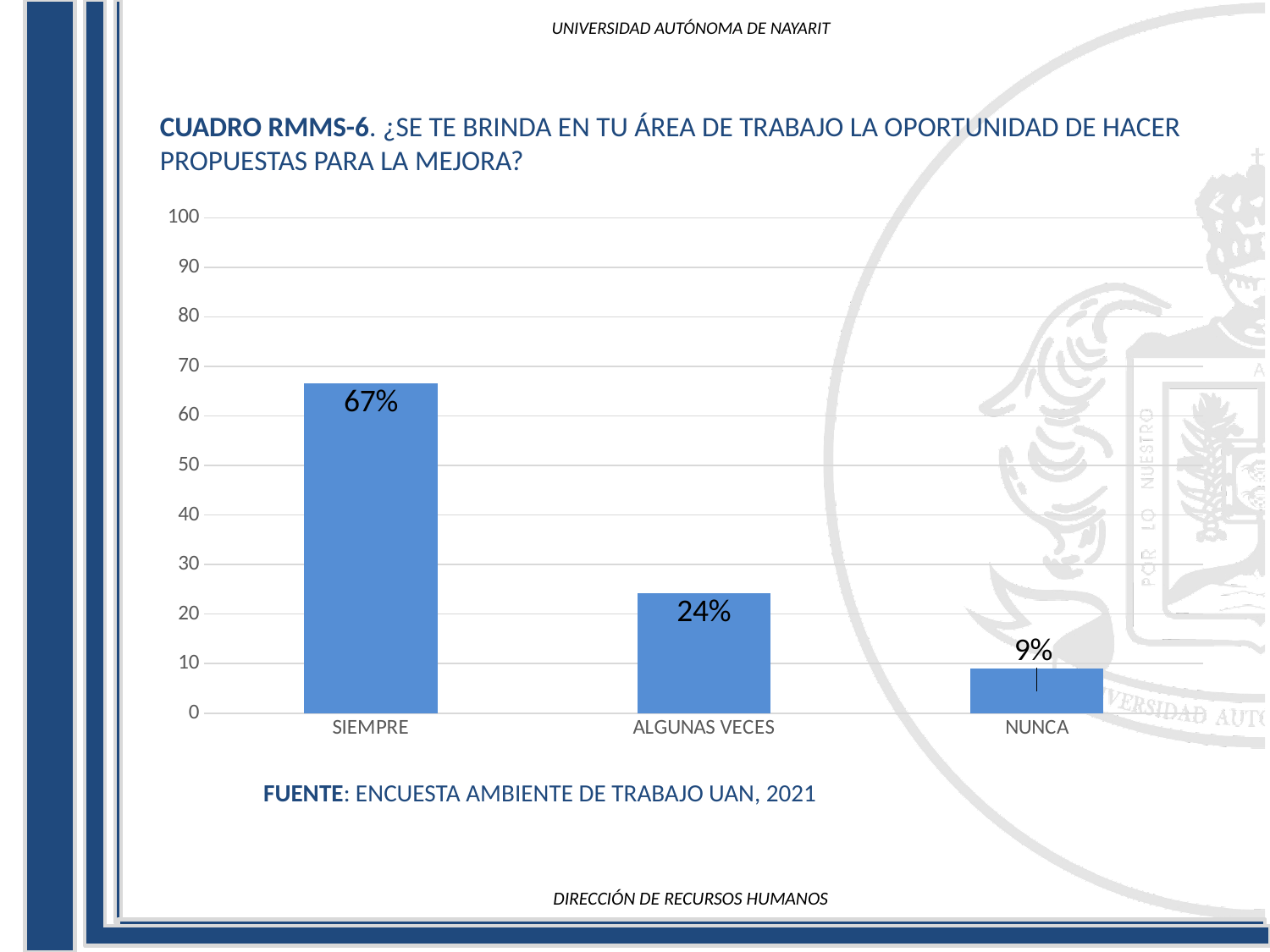
What is the value for NUNCA? 9% What is the difference between the values for SIEMPRE and ALGUNAS VECES? 43% What is the value for ALGUNAS VECES? 24% Is the value for SIEMPRE greater or less than 60? greater What is the value for SIEMPRE? 67% What is the difference between the values for ALGUNAS VECES and NUNCA? 15% What kind of chart is shown on the slide? bar chart Do the values rise or fall from left to right along the x axis? fall Which category has the lowest value? NUNCA How many categories are shown on the x axis? 3 Which is larger, the value for ALGUNAS VECES or the value for NUNCA? ALGUNAS VECES Which category has the highest value? SIEMPRE